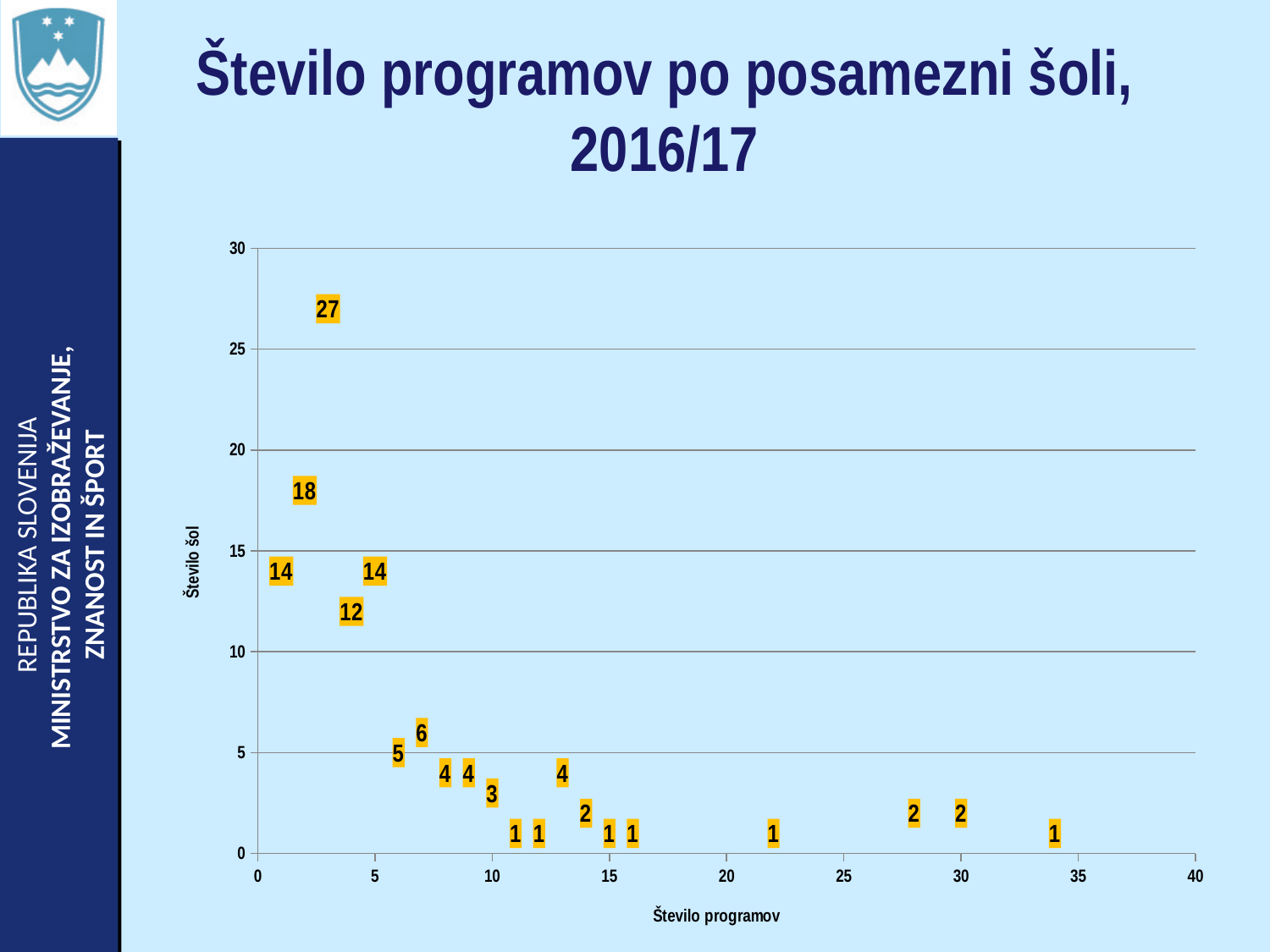
Which is larger: the value at 4 programs or the value at 5 programs? 5 programs (14) What is the highest value labelled on the chart? 27 What is the value of the point at 34 programs (Število programov = 34)? 1 What kind of chart is shown on the slide? scatter chart Do the values generally rise or fall as the number of programs increases along the x axis? fall How many data points are plotted on the chart? 20 What is the lowest value labelled on the chart? 1 What is the title of the y axis? Število šol What is the value of the point at 3 programs (Število programov = 3)? 27 What is the difference between the highest labelled value (27) and the second highest (18)? 9 What is the value of the point at 2 programs (Število programov = 2)? 18 Is the value of the point at 3 programs greater or less than 25? greater